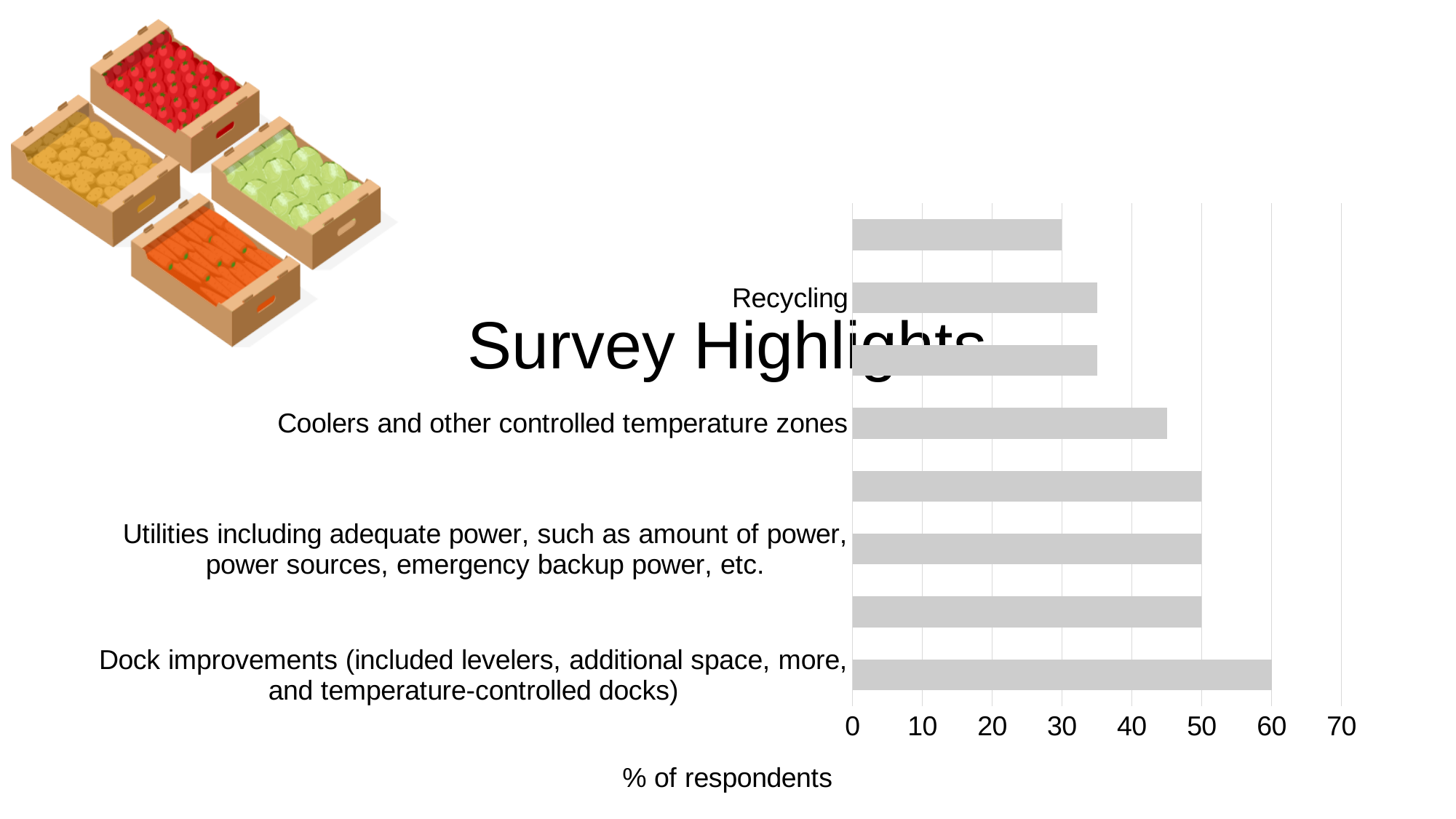
Which category has the highest value in the chart? Dock improvements (included levelers, additional space, more, and temperature-controlled docks) How many bars does the chart contain? 8 What is the value for Utilities including adequate power, such as amount of power, power sources, emergency backup power, etc.? 50 Is the value for Recycling greater or less than 40? less What kind of chart is shown on the slide? bar chart What is the label of the horizontal axis of the chart? % of respondents What is the value for Dock improvements (included levelers, additional space, more, and temperature-controlled docks)? 60 Is the value for Coolers and other controlled temperature zones greater or less than 50? less Is the value for Coolers and other controlled temperature zones greater or less than 40? greater Which is larger: the value for Recycling or the value for Coolers and other controlled temperature zones? Coolers and other controlled temperature zones Which is larger: the value for Dock improvements or the value for Utilities including adequate power? Dock improvements